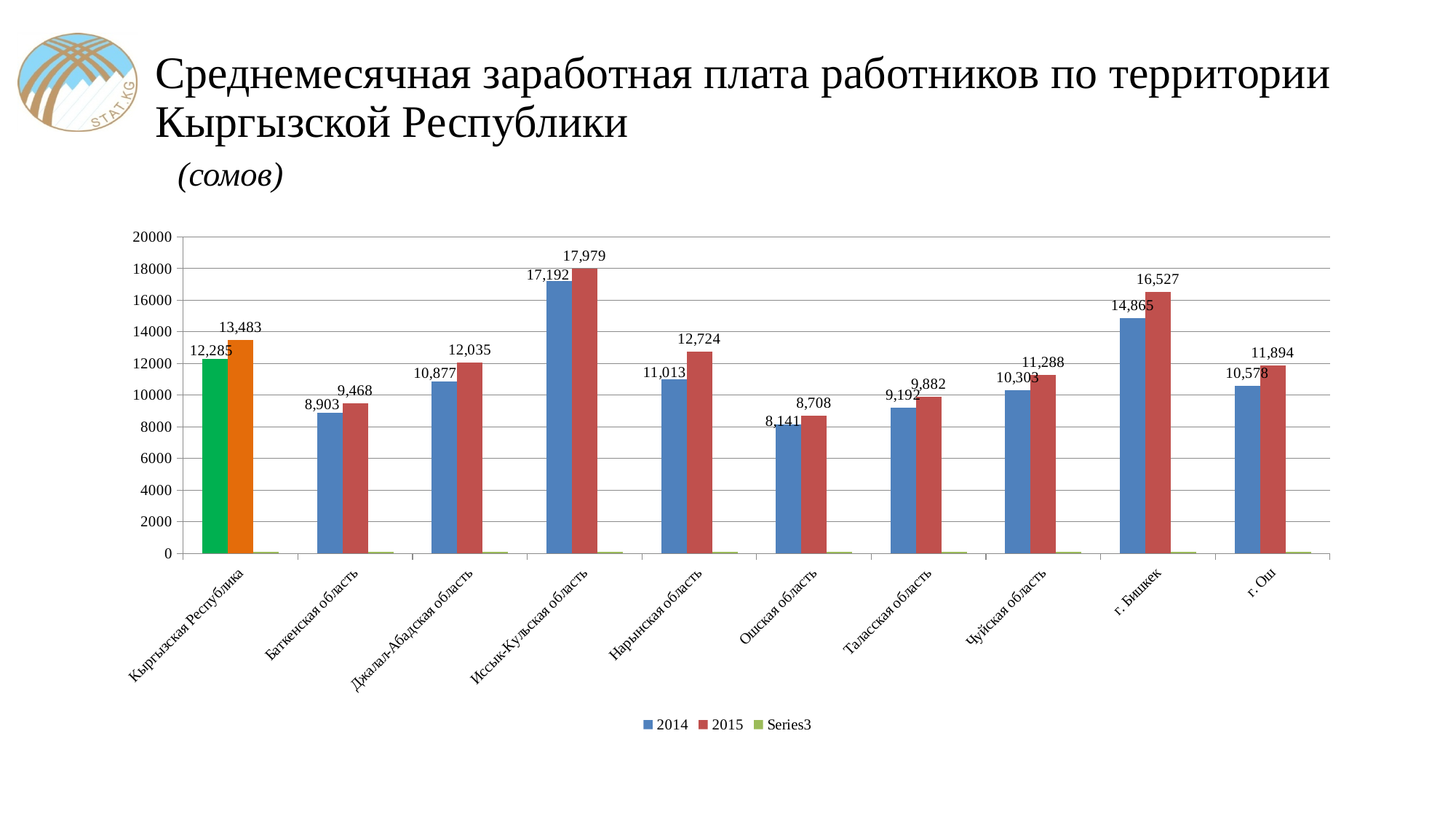
What is the 2015 value for Кыргызская Республика? 13,483 Is the 2014 value for Чуйская область greater or less than 12000? less What is the 2015 value for Иссык-Кульская область? 17,979 What is the difference between the 2015 and 2014 values for г. Бишкек? 1,662 Which category has the lowest 2014 value? Ошская область How many categories are shown on the x axis? 10 What kind of chart is shown on the slide? bar chart Which is larger: the 2015 value for Нарынская область or the 2015 value for Джалал-Абадская область? Нарынская область What unit is given in italics below the slide title? сомов What is the 2014 value for г. Бишкек? 14,865 How many series does the legend list? 3 Which category has the highest 2015 value? Иссык-Кульская область